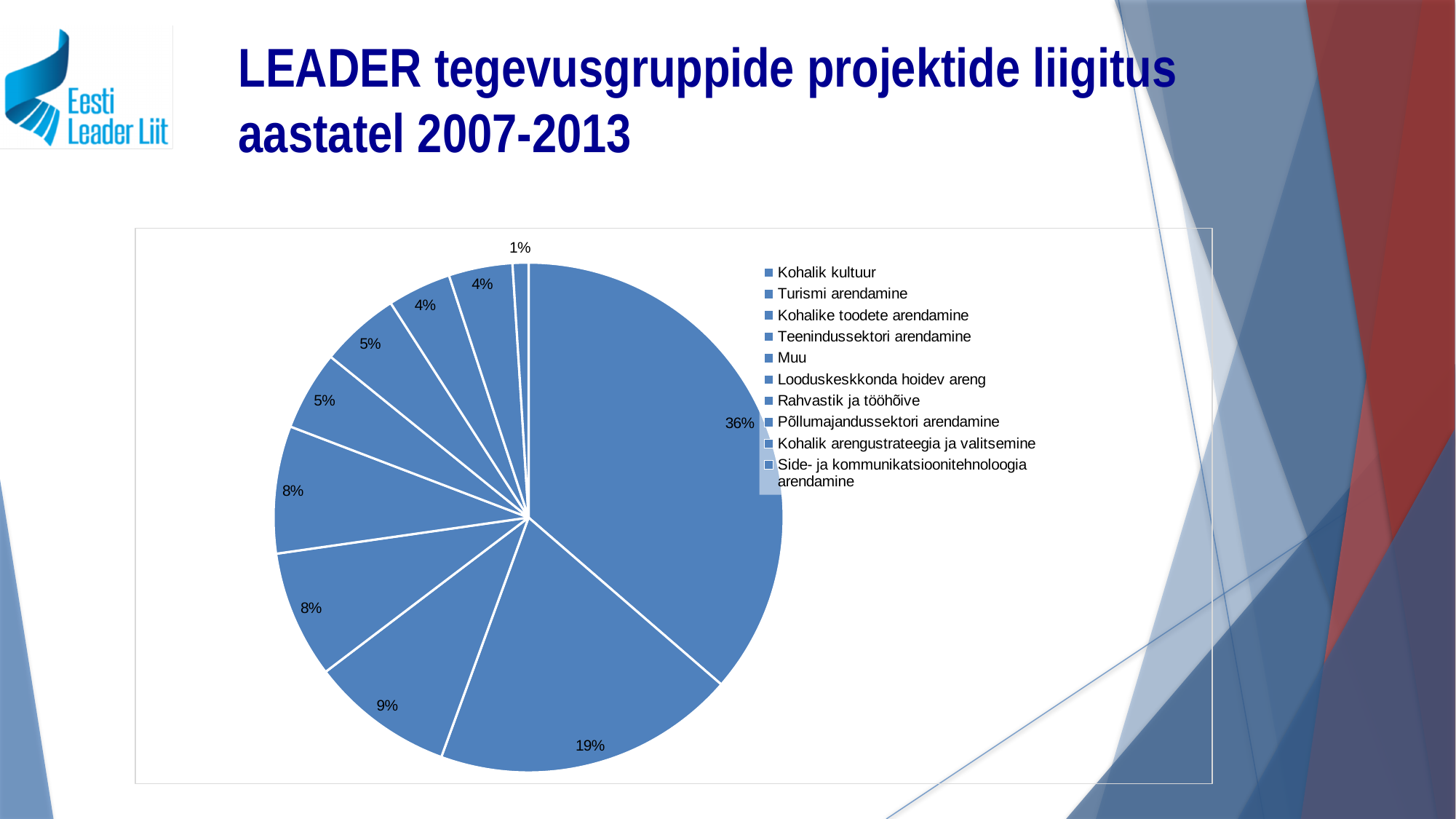
What is the combined share of the two largest slices (36% and 19%)? 55% What is the difference between the largest slice (36%) and the second-largest slice (19%)? 17 percentage points Which is larger: the 9% slice or the 8% slice? the 9% slice What kind of chart is shown on the slide? pie chart What is the second-largest percentage shown on the pie chart? 19% What is the smallest percentage shown on the pie chart? 1% Which category is listed last in the legend of the pie chart? Side- ja kommunikatsioonitehnoloogia arendamine How many slices of the pie chart are labelled 8%? 2 How many slices of the pie chart are labelled 5%? 2 How many categories does the legend of the pie chart list? 10 Which category is listed first in the legend of the pie chart? Kohalik kultuur What is the largest percentage shown on the pie chart? 36%